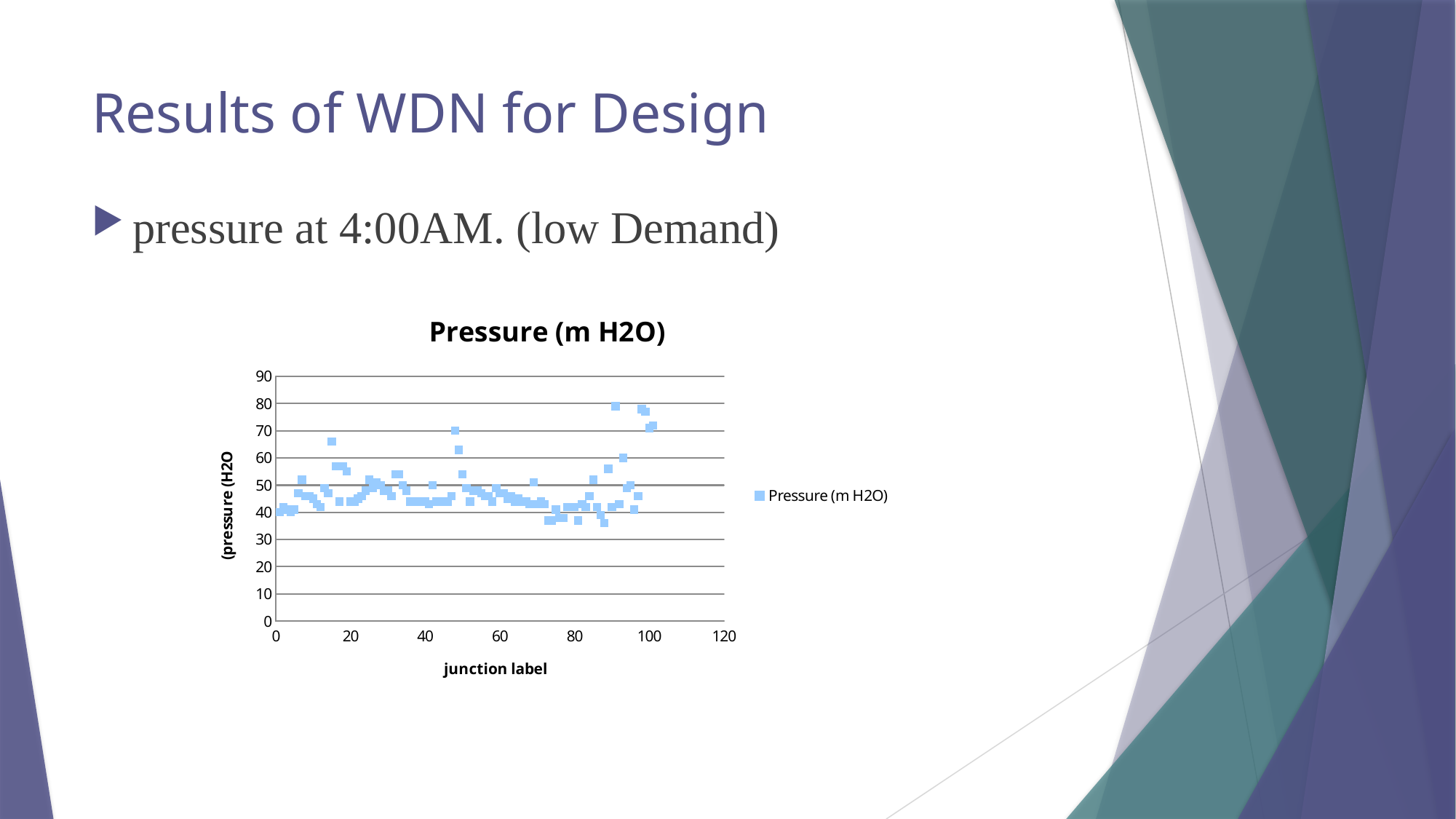
What is the highest tick value shown on the x axis? 120 What is the highest tick value shown on the y axis? 90 Is the pressure at junction label 15 greater or less than 60? greater What is the title of the chart? Pressure (m H2O) How many series does the chart legend list? 1 Is the highest plotted pressure value greater or less than 90? less Is the pressure at junction label 48 greater or less than 60? greater What is the label on the x axis of the chart? junction label What kind of chart is shown on the slide? scatter chart